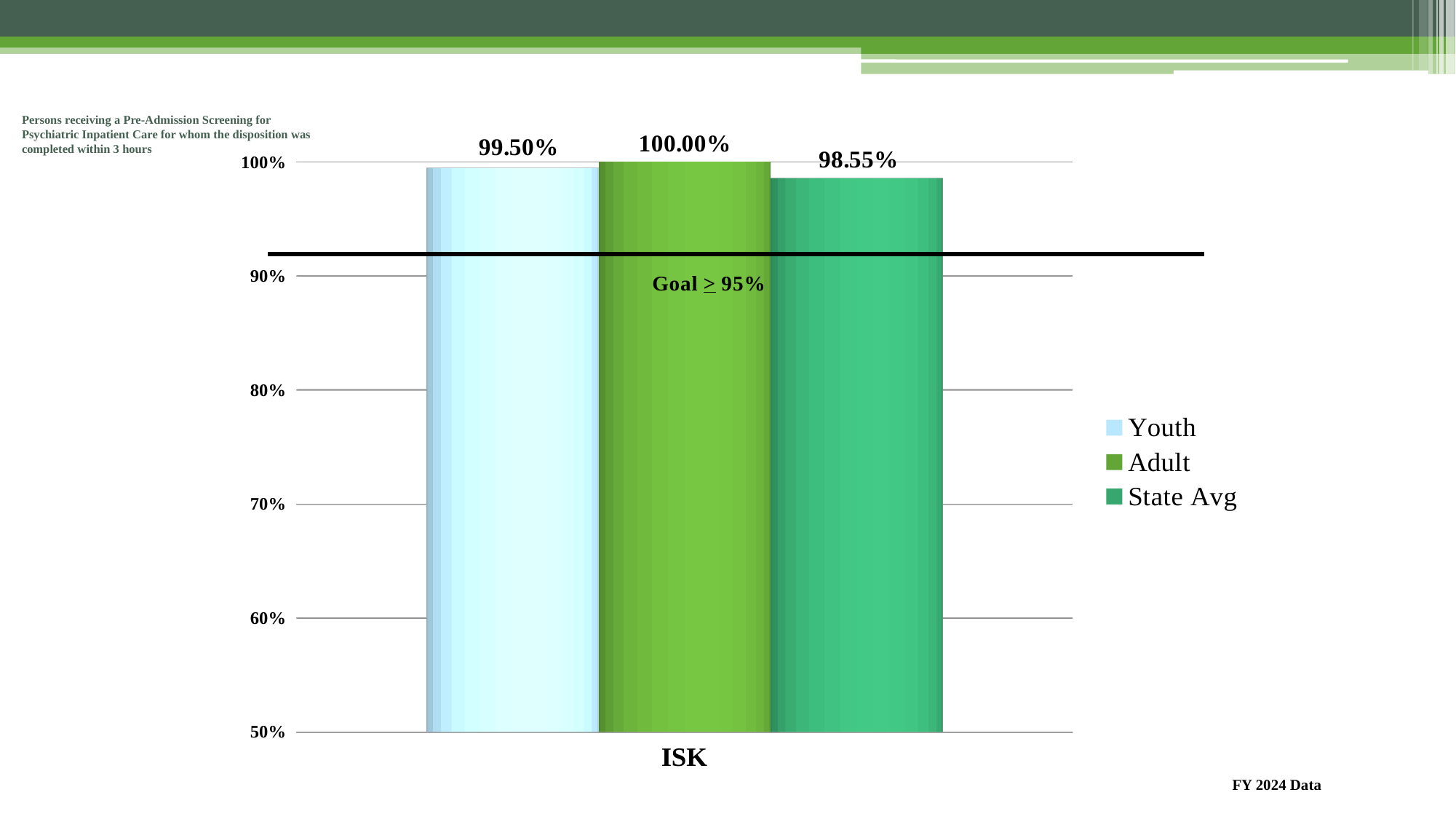
What goal is marked by the horizontal line on the chart? Goal ≥ 95% What kind of chart is shown? bar chart Is the value for State Avg greater or less than 90%? greater How many series does the legend list? 3 Which is larger, the Youth value or the State Avg value? Youth What is the value for Youth? 99.50% Which series has the lowest value? State Avg What is the value for Adult? 100.00% What is the difference between the Adult value and the State Avg value? 1.45% What is the difference between the Youth value and the State Avg value? 0.95% Which series has the highest value? Adult What is the value for State Avg? 98.55%